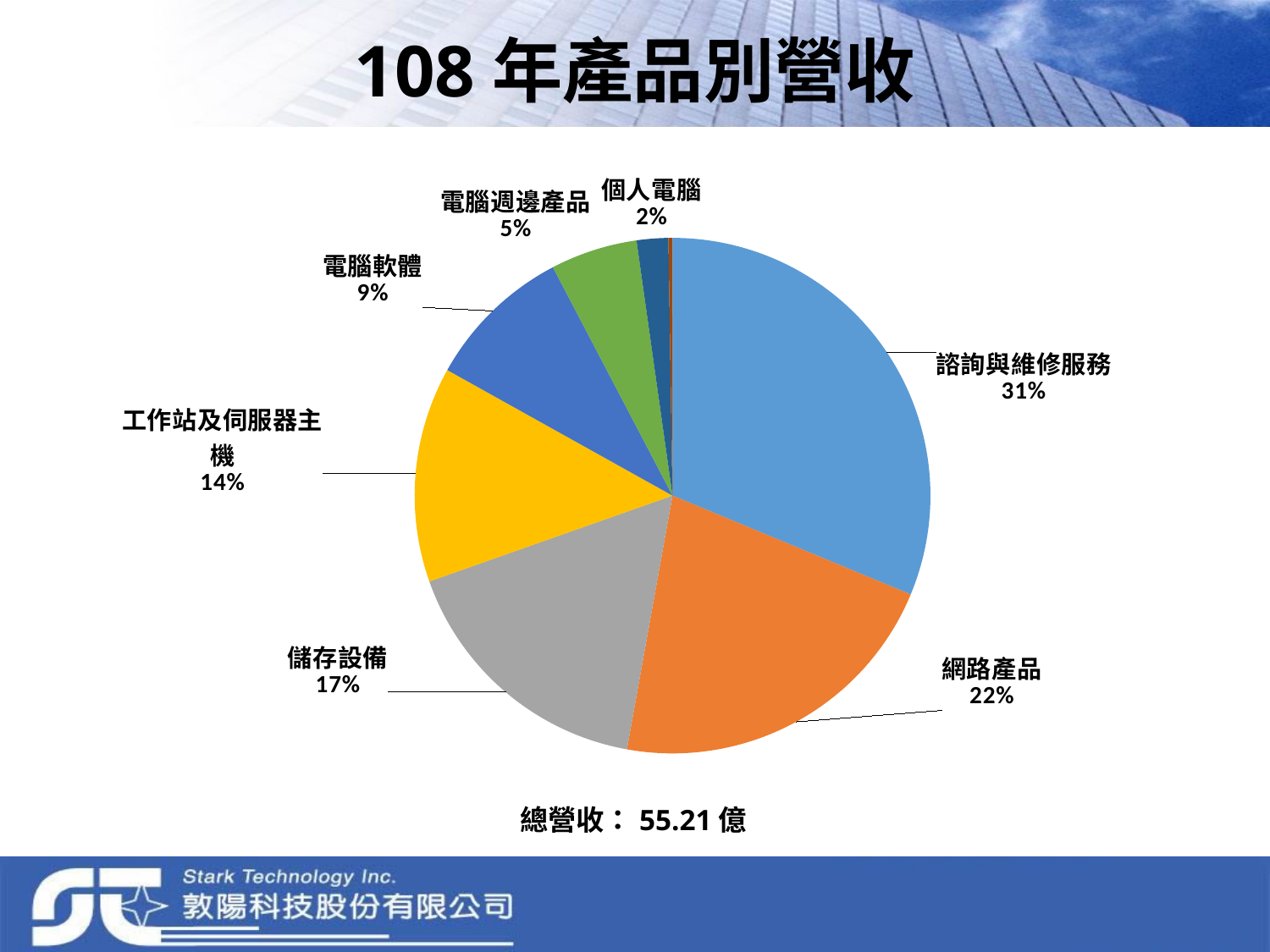
Which has a larger share, 電腦軟體 or 電腦週邊產品? 電腦軟體 What percentage is shown for 網路產品? 22% What percentage is shown for 工作站及伺服器主機? 14% How many product categories have percentage labels on the pie chart? 7 What percentage is shown for 儲存設備? 17% Which labeled product category has the smallest share of revenue? 個人電腦 What total revenue is stated below the chart? 55.21 億 Which product category has the largest share of revenue? 諮詢與維修服務 What share of revenue does 諮詢與維修服務 account for? 31% What kind of chart is shown on the slide? pie chart What percentage is shown for 電腦軟體? 9% What is the difference in percentage points between 網路產品 and 儲存設備? 5